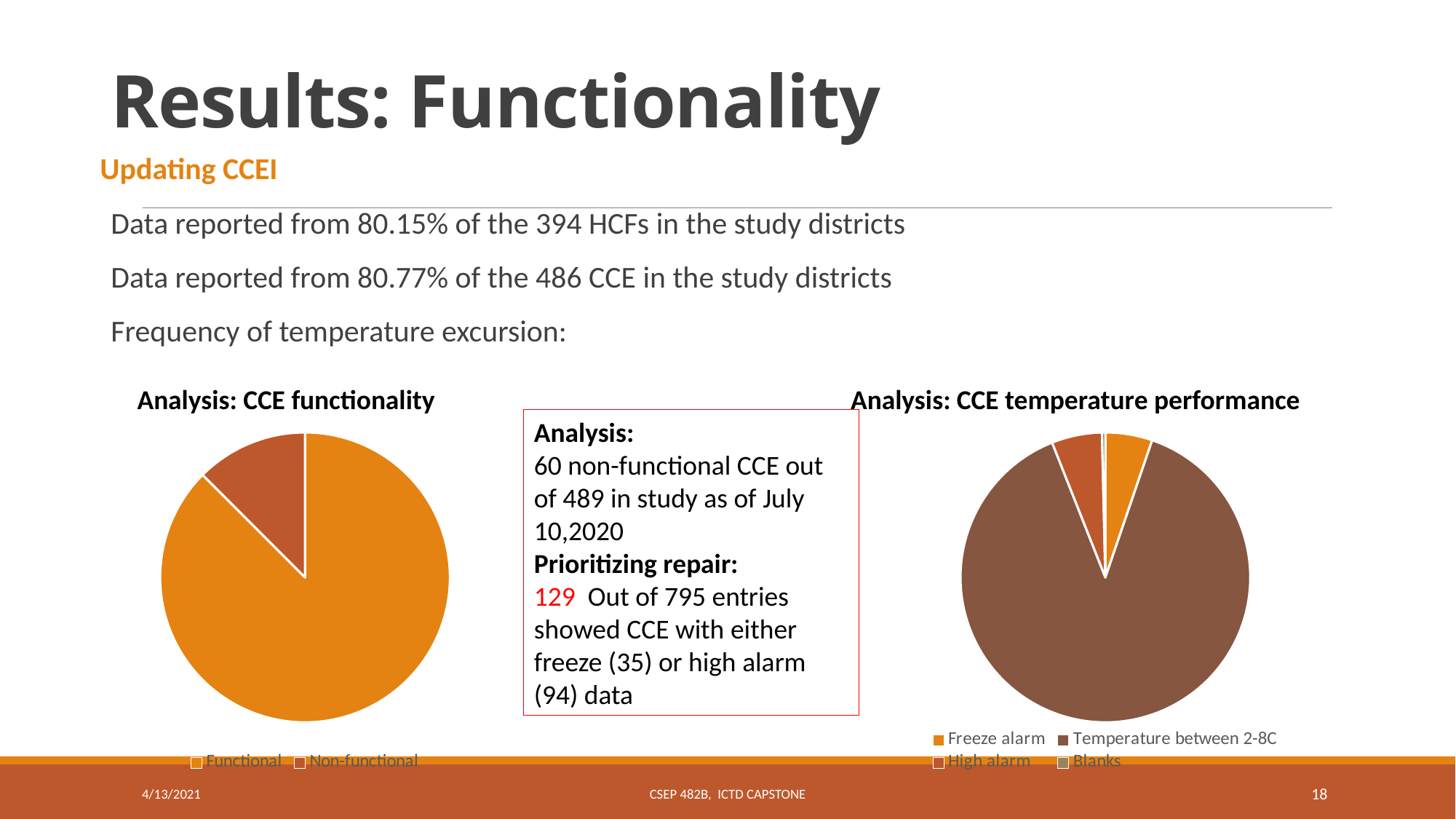
In the 'Analysis: CCE temperature performance' chart, which category has the smallest slice? Blanks In the 'Analysis: CCE temperature performance' chart, which category has the largest slice? Temperature between 2-8C What kind of chart is the 'Analysis: CCE functionality' chart? pie chart In the 'Analysis: CCE functionality' chart, how many categories does the legend list? 2 In the 'Analysis: CCE temperature performance' chart, which category is shown in the dark brown colour? Temperature between 2-8C In the 'Analysis: CCE functionality' chart, which slice is larger: Functional or Non-functional? Functional What is the title of the pie chart on the left side of the slide? Analysis: CCE functionality In the 'Analysis: CCE functionality' chart, which category has the largest slice? Functional In the 'Analysis: CCE temperature performance' chart, how many categories does the legend list? 4 What kind of chart is the 'Analysis: CCE temperature performance' chart? pie chart In the 'Analysis: CCE functionality' chart, which category has the smallest slice? Non-functional